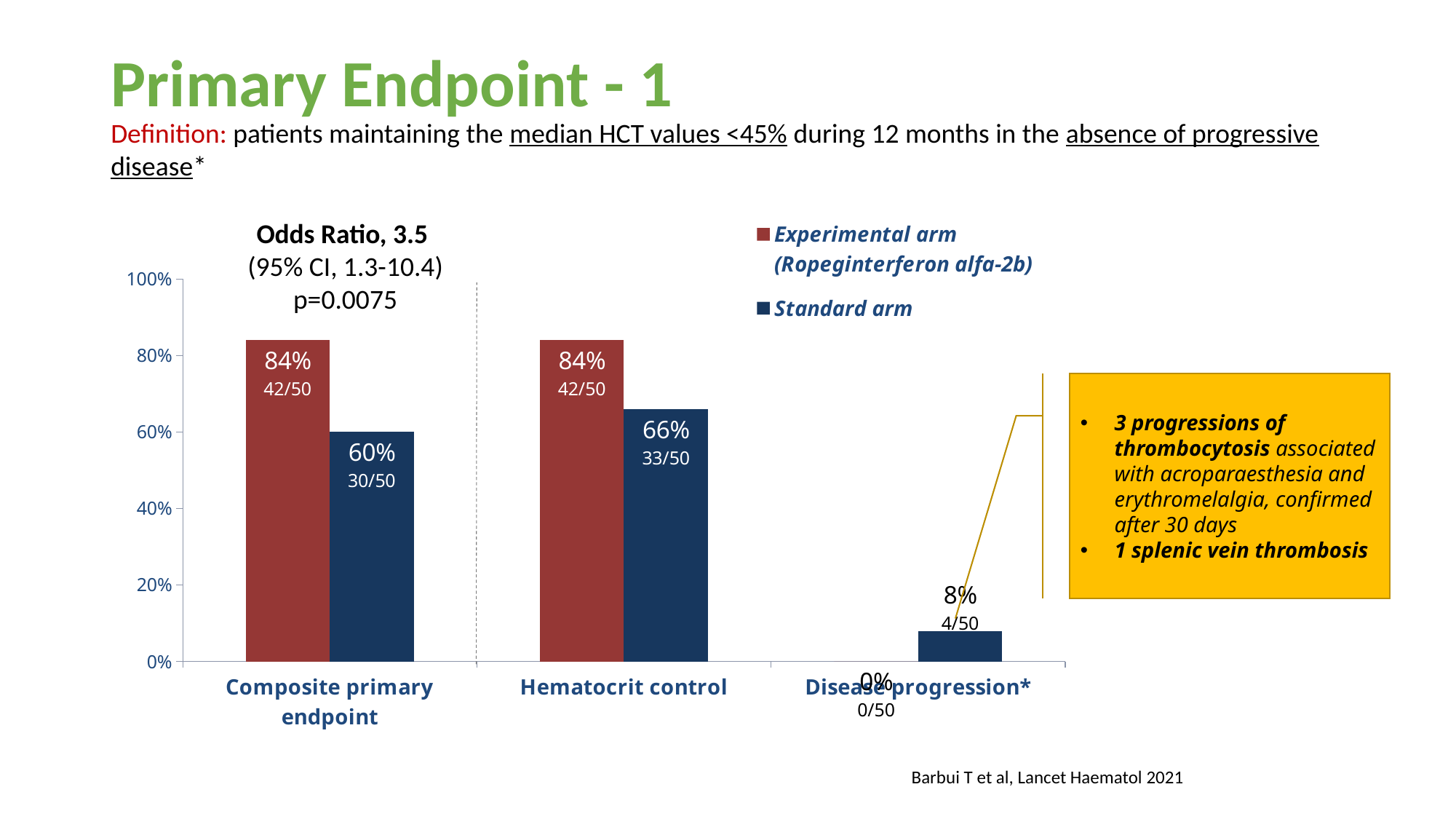
How many categories are shown on the x axis? 3 How many series does the legend list? 2 What is the value for the Standard arm in the Hematocrit control category? 66% What is the value for the Standard arm in the Disease progression* category? 8% What is the value for the Experimental arm in the Disease progression* category? 0% What kind of chart is shown on the slide? Bar chart What is the difference between the Experimental arm and Standard arm values in the Hematocrit control category? 18% What is the difference between the Experimental arm and Standard arm values in the Composite primary endpoint category? 24% Which category has the lowest value for the Standard arm? Disease progression* What is the value for the Experimental arm in the Composite primary endpoint category? 84% Which arm has the larger value in the Hematocrit control category? Experimental arm What is the value for the Standard arm in the Composite primary endpoint category? 60%